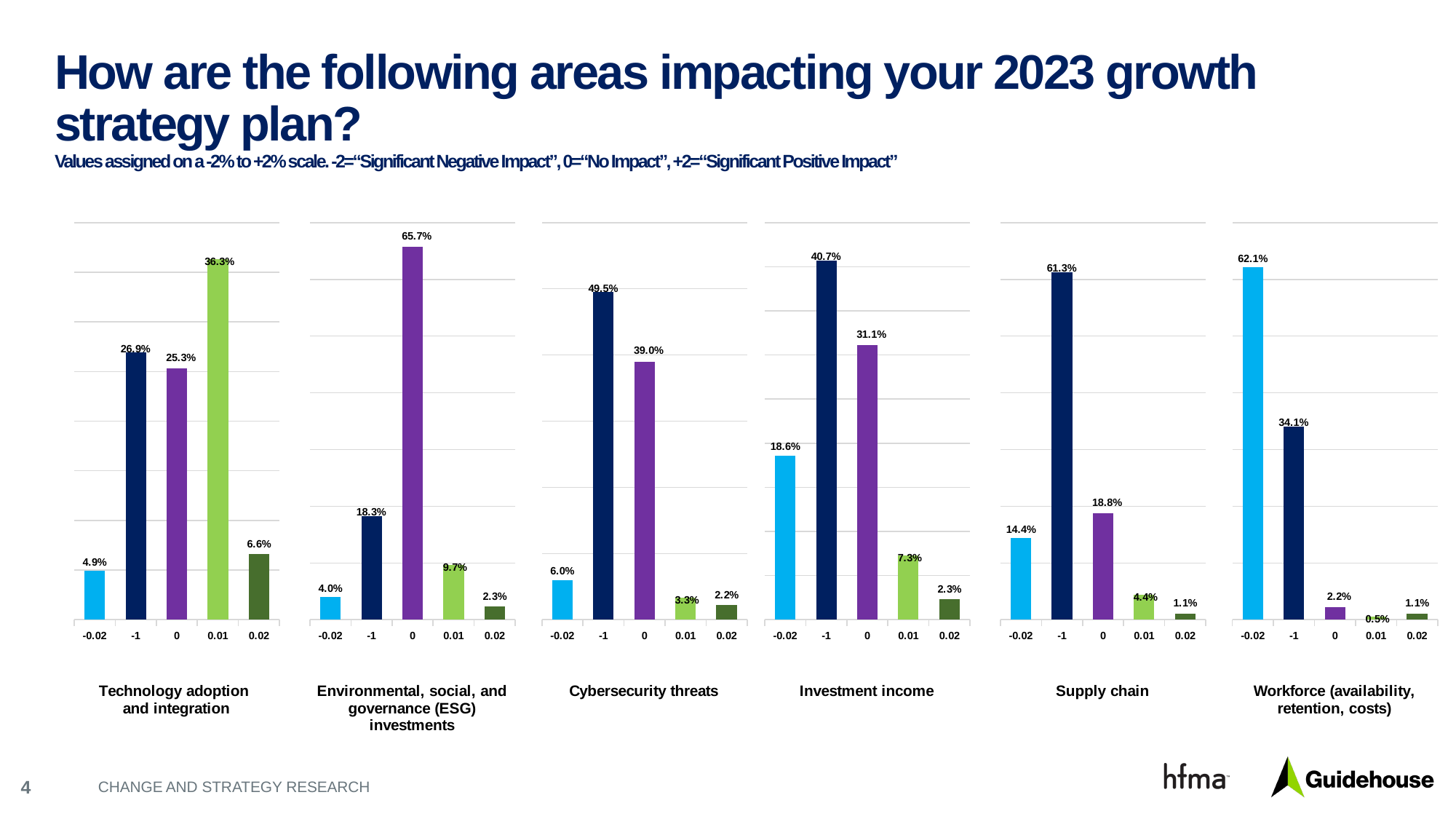
In the Workforce (availability, retention, costs) chart, what is the value for the -0.02 category? 62.1% In the Technology adoption and integration chart, what is the value for the 0.01 category? 36.3% How many categories are shown on the x axis of the Supply chain chart? 5 In the Environmental, social, and governance (ESG) investments chart, which category has the lowest value? 0.02 In the Investment income chart, which is larger, the value for -0.02 or the value for 0? 0 How many separate charts are shown on the slide? 6 In the Environmental, social, and governance (ESG) investments chart, what is the value for the 0 category? 65.7% In the Workforce (availability, retention, costs) chart, which category has the lowest value? 0.01 In the Supply chain chart, what is the difference between the values for -1 and 0? 42.5% In the Cybersecurity threats chart, what is the difference between the values for -1 and 0? 10.5% In the Cybersecurity threats chart, which category has the highest value? -1 What kind of chart is the Investment income chart? bar chart